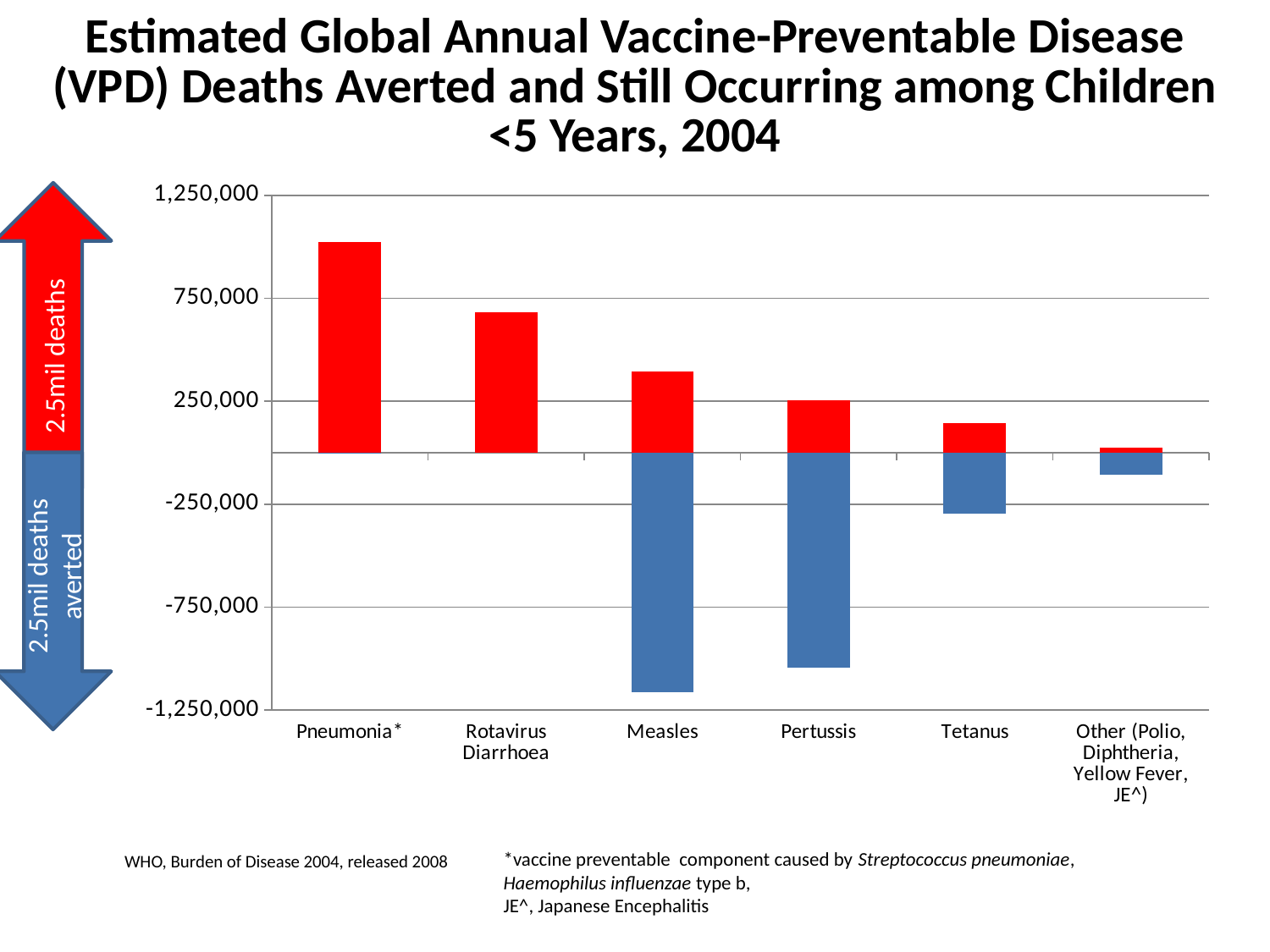
Is the blue bar value for Tetanus greater or less than -750,000? greater Is the red bar value for Pneumonia* greater or less than 750,000? greater Is the red bar value for Measles greater or less than 250,000? greater Which disease has the tallest red bar (deaths still occurring)? Pneumonia* Which disease has the largest blue bar (deaths averted)? Measles Which has the larger red bar, Pneumonia* or Rotavirus Diarrhoea? Pneumonia* What kind of chart is shown on the slide? bar chart Do the red bars rise or fall moving from left to right across the x axis? fall Which disease has the smallest red bar (deaths still occurring)? Other (Polio, Diphtheria, Yellow Fever, JE^) How many disease categories are shown on the x axis? 6